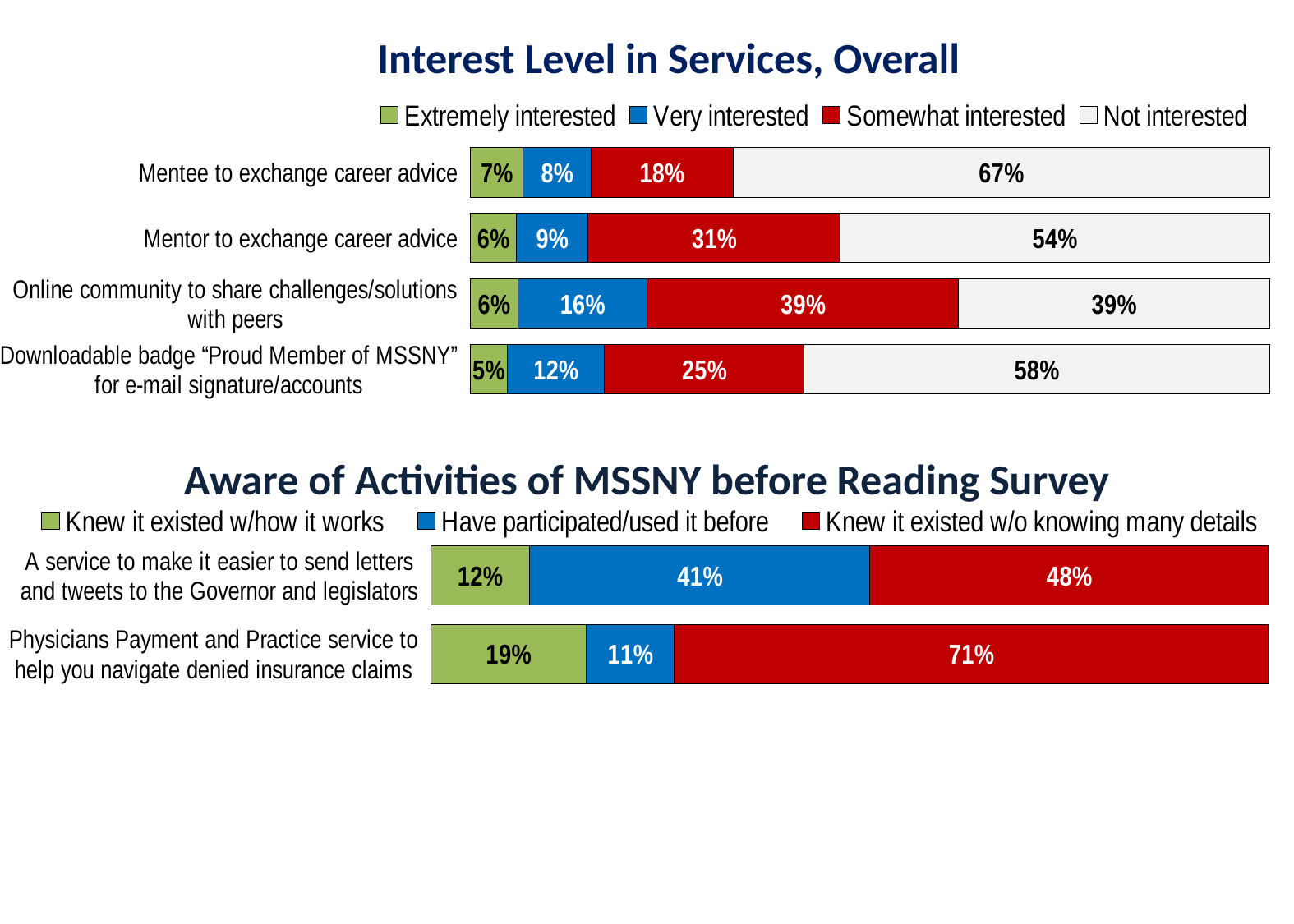
In the 'Interest Level in Services, Overall' chart, what percentage is 'Very interested' for 'Online community to share challenges/solutions with peers'? 16% In the 'Interest Level in Services, Overall' chart, how many services are shown? 4 In the 'Interest Level in Services, Overall' chart, what percentage is 'Not interested' for 'Mentee to exchange career advice'? 67% In the 'Aware of Activities of MSSNY before Reading Survey' chart, what percentage 'Have participated/used it before' for 'A service to make it easier to send letters and tweets to the Governor and legislators'? 41% In the 'Aware of Activities of MSSNY before Reading Survey' chart, what percentage 'Knew it existed w/o knowing many details' for 'Physicians Payment and Practice service to help you navigate denied insurance claims'? 71% In the 'Interest Level in Services, Overall' chart, how many series does the legend list? 4 In the 'Interest Level in Services, Overall' chart, which service has the highest 'Not interested' percentage? Mentee to exchange career advice In the 'Interest Level in Services, Overall' chart, what is the difference between the 'Not interested' percentages for 'Mentee to exchange career advice' and 'Mentor to exchange career advice'? 13% What type of chart is the 'Aware of Activities of MSSNY before Reading Survey' chart? Stacked bar chart In the 'Interest Level in Services, Overall' chart, which service has the lowest 'Extremely interested' percentage? Downloadable badge "Proud Member of MSSNY" for e-mail signature/accounts In the 'Interest Level in Services, Overall' chart, what percentage is 'Somewhat interested' for 'Mentor to exchange career advice'? 31% In the 'Aware of Activities of MSSNY before Reading Survey' chart, which activity has the larger 'Knew it existed w/how it works' percentage? Physicians Payment and Practice service to help you navigate denied insurance claims